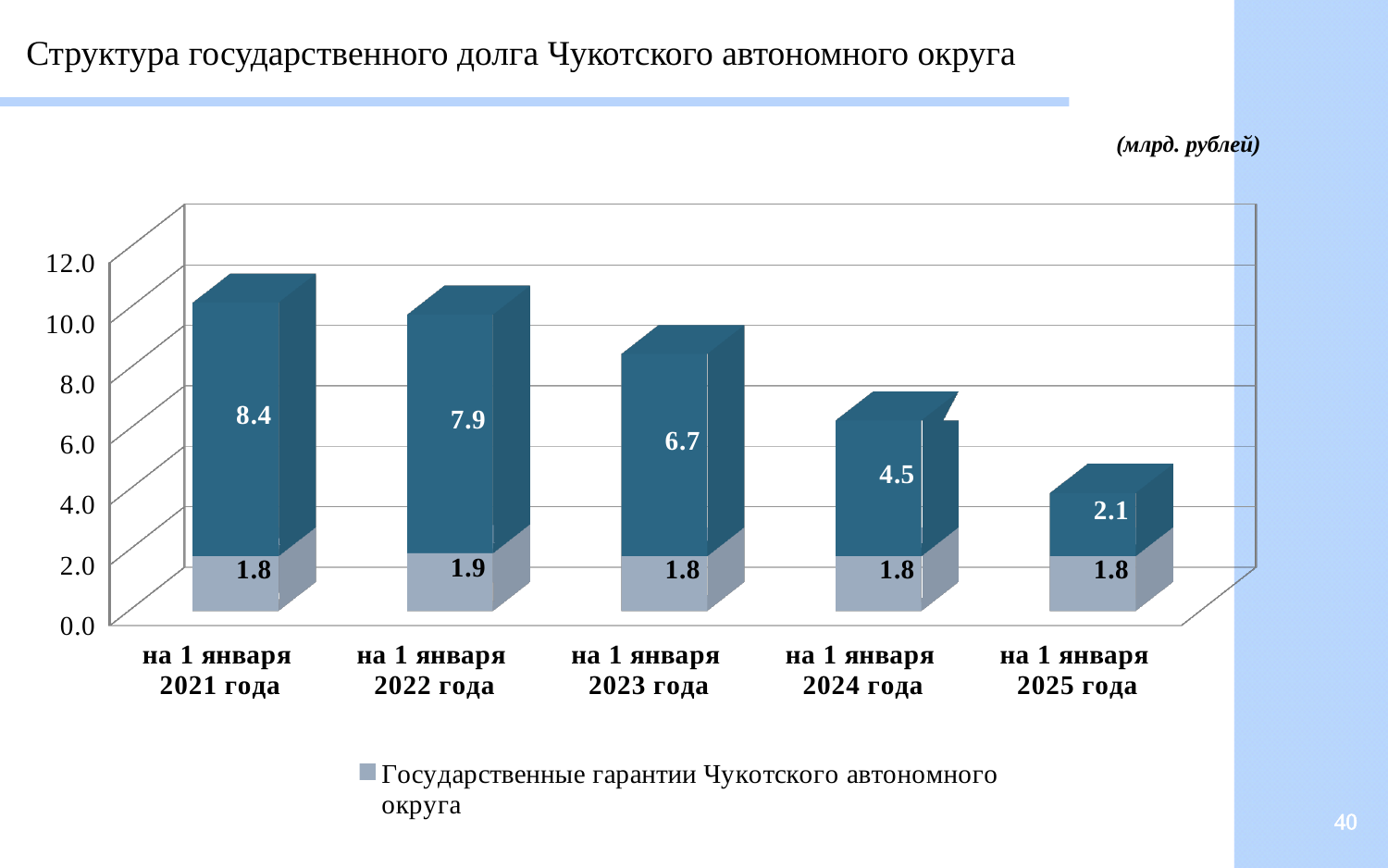
For which date is the dark blue segment the largest? на 1 января 2021 года What type of chart is shown on the slide? Stacked bar chart What is the value of the dark blue segment for 'на 1 января 2021 года'? 8.4 For which date is the dark blue segment the smallest? на 1 января 2025 года What is the value of the dark blue segment for 'на 1 января 2025 года'? 2.1 What unit is stated for the chart values? млрд. рублей Do the dark blue segment values rise or fall from 'на 1 января 2021 года' to 'на 1 января 2025 года'? Fall What is the value of 'Государственные гарантии Чукотского автономного округа' for 'на 1 января 2022 года'? 1.9 How many dates (categories) are shown on the x axis? 5 What is the difference between the dark blue segment values for 'на 1 января 2023 года' and 'на 1 января 2024 года'? 2.2 Which is larger: the dark blue segment for 'на 1 января 2022 года' or for 'на 1 января 2023 года'? на 1 января 2022 года What is the total of the stacked bar for 'на 1 января 2021 года'? 10.2